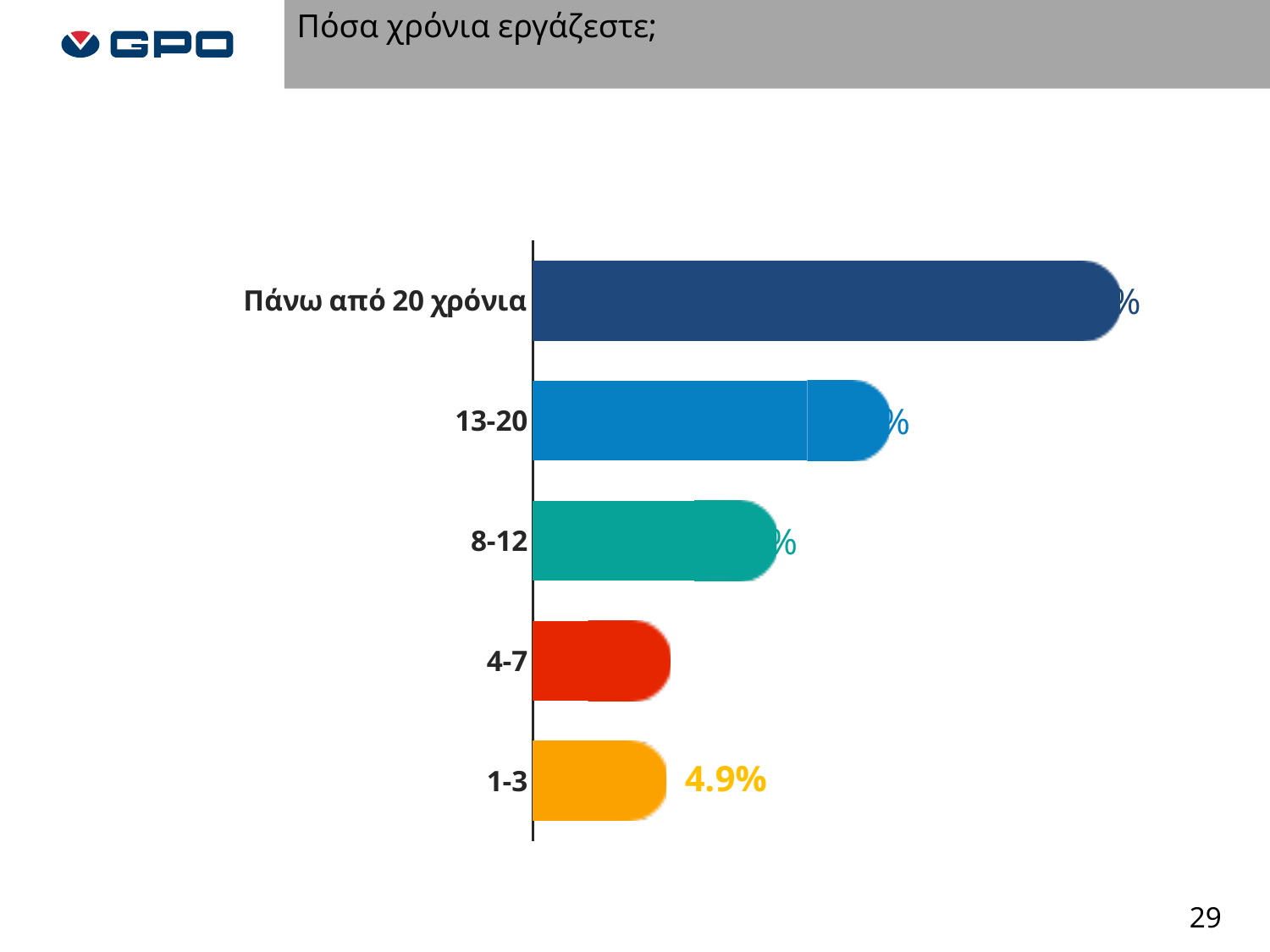
What colour is the bar for the category 1-3? orange Which category is listed at the top of the chart? Πάνω από 20 χρόνια What is the title of the chart? Πόσα χρόνια εργάζεστε; Which is larger, the value for 8-12 or the value for 1-3? 8-12 Which is larger, the value for 8-12 or the value for 4-7? 8-12 Which category has the highest value? Πάνω από 20 χρόνια What is the value for the category 1-3? 4.9% Which is larger, the value for Πάνω από 20 χρόνια or the value for 13-20? Πάνω από 20 χρόνια What type of chart is shown on the slide? bar chart How many categories are shown in the chart? 5